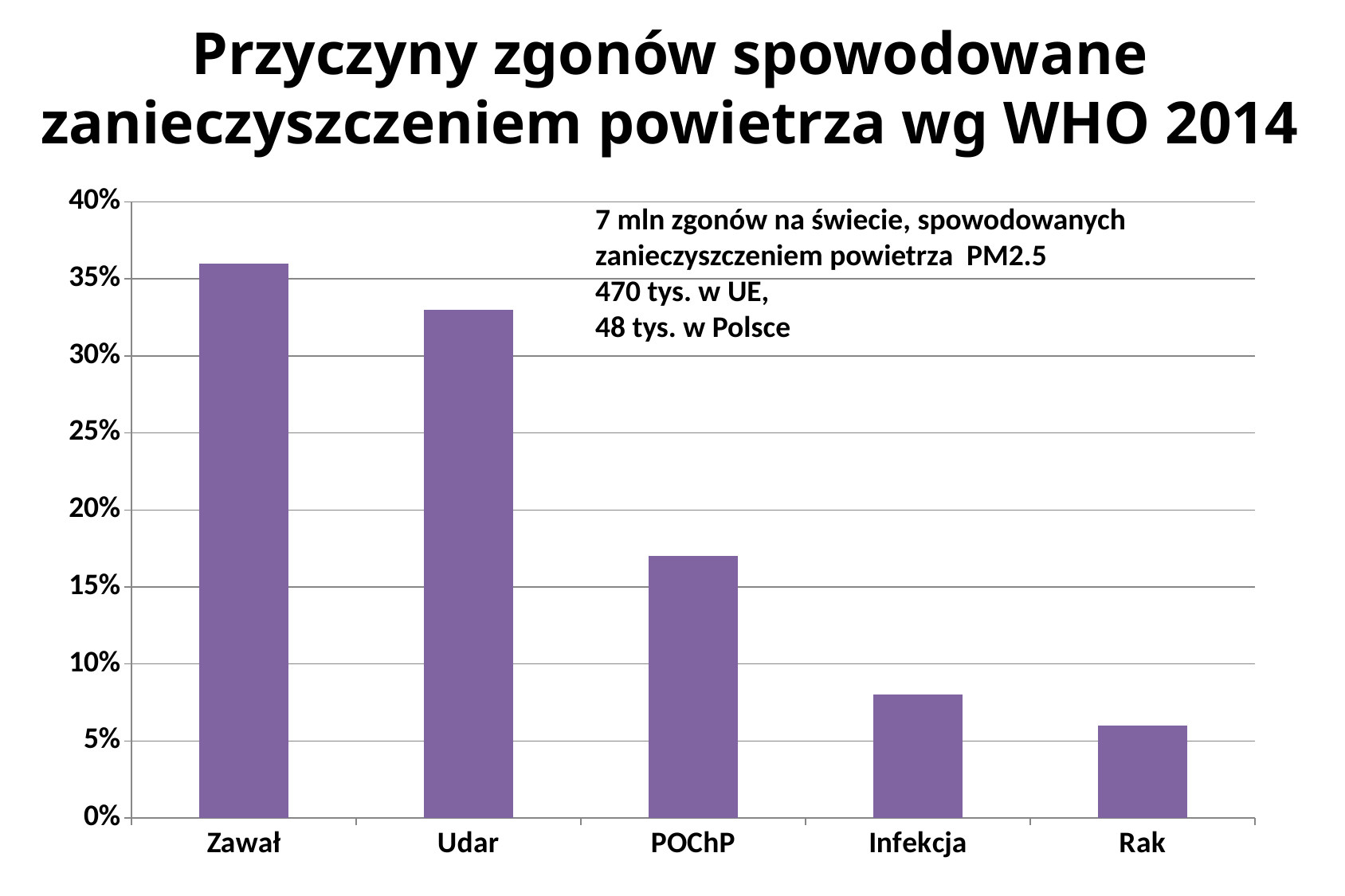
Do the bar values rise or fall from left to right along the x axis? fall Is the value for Infekcja greater or less than 10%? less Which category has the highest bar in the chart? Zawał What kind of chart is shown on the slide? bar chart How many categories are shown on the x axis of the chart? 5 Is the value for Rak greater or less than 5%? greater Is the value for POChP greater or less than 20%? less What is the title of the chart on the slide? Przyczyny zgonów spowodowane zanieczyszczeniem powietrza wg WHO 2014 Which category has the lowest bar in the chart? Rak Which is larger, the value for Udar or the value for POChP? Udar